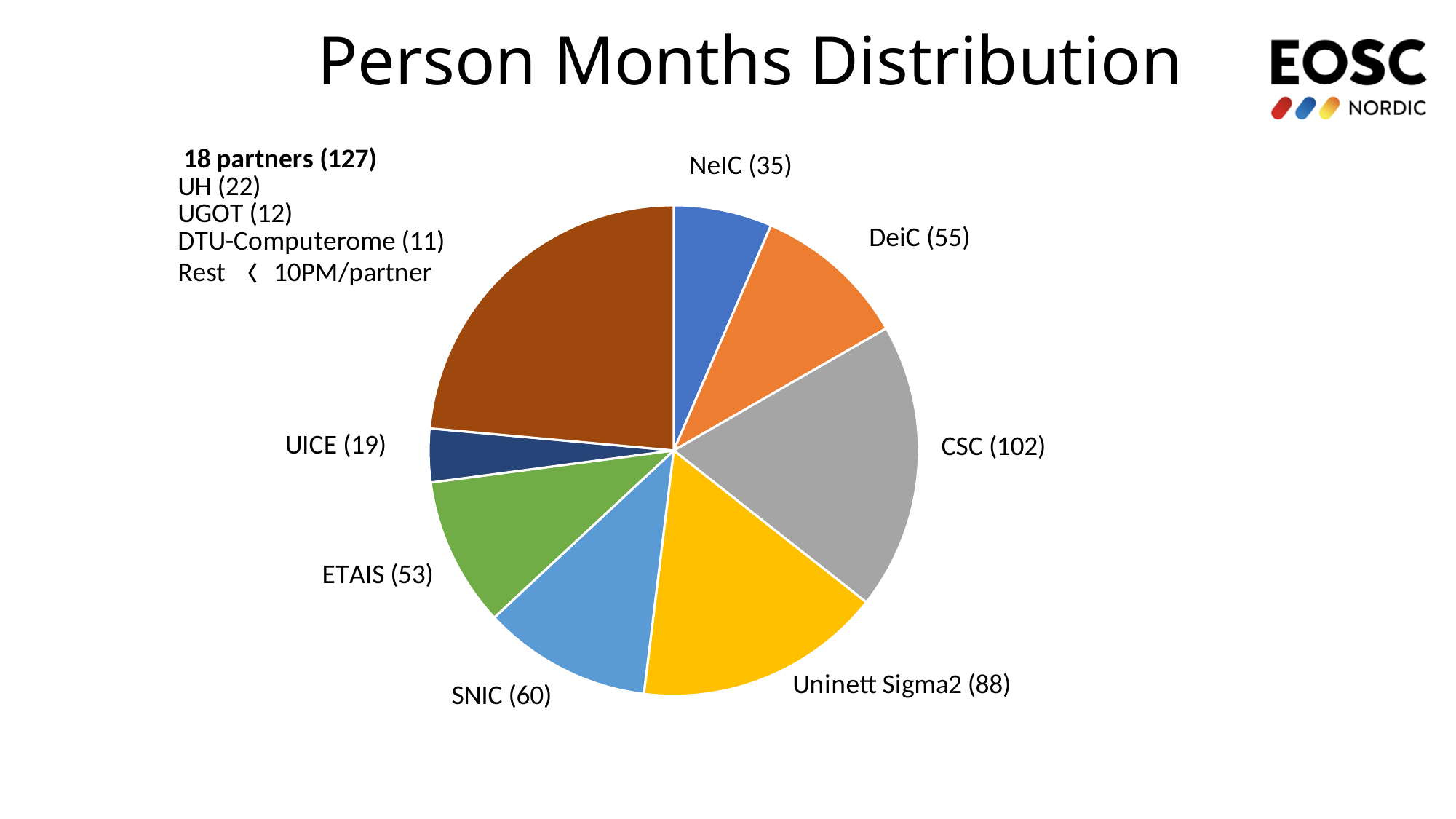
What is the value for SNIC in the pie chart? 60 What is the value for CSC in the pie chart? 102 What value is shown for the '18 partners' slice? 127 What is the title of the chart? Person Months Distribution How many slices does the pie chart have? 8 Which slice of the pie chart has the lowest value? UICE Which has a larger value, DeiC or ETAIS? DeiC What is the difference between the values for SNIC and NeIC? 25 What is the value for NeIC in the pie chart? 35 What is the difference between the values for CSC and Uninett Sigma2? 14 Which single named organisation has the highest value in the pie chart? CSC What type of chart is shown on the slide? Pie chart